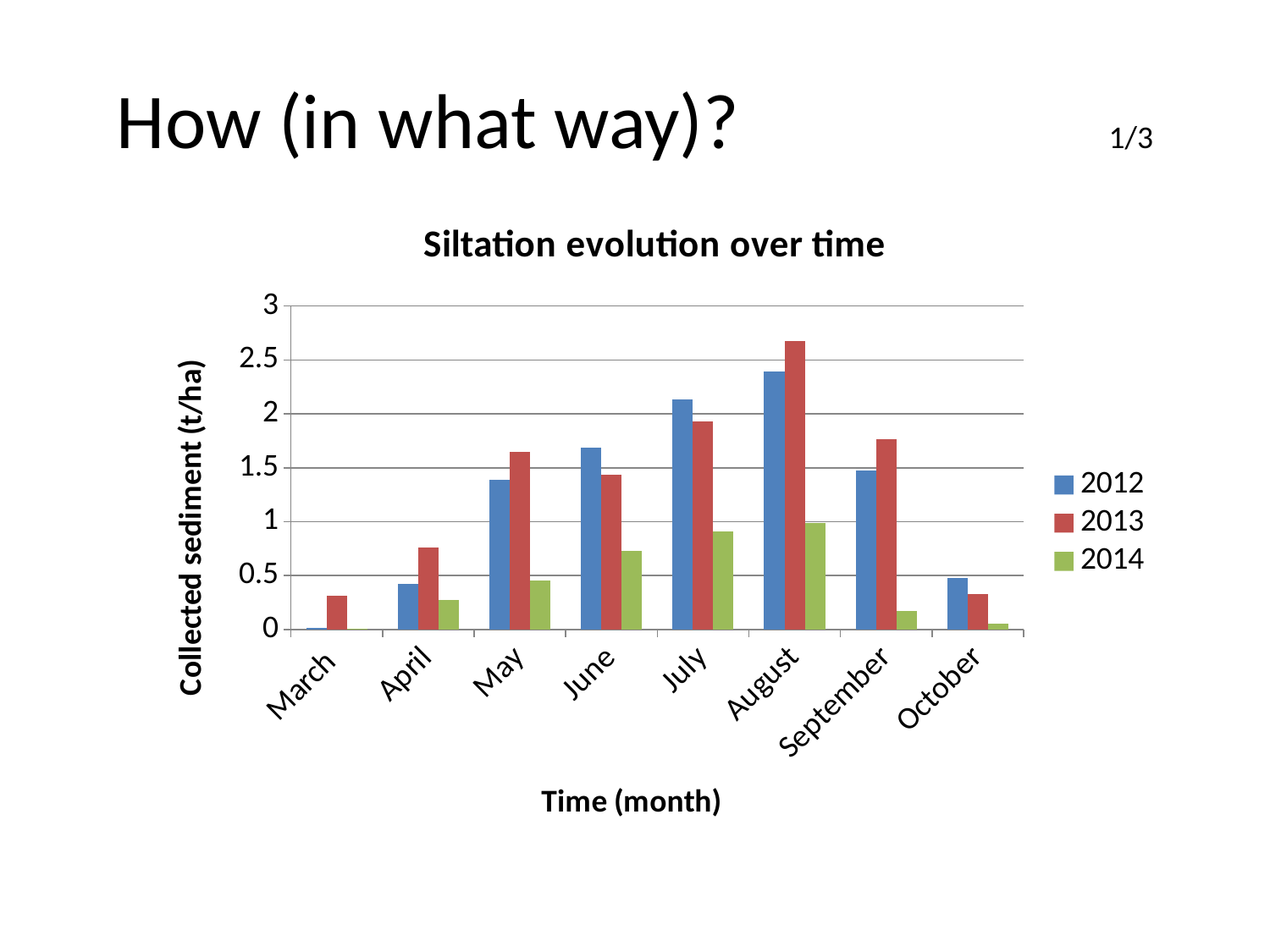
In May, which series has the larger value, 2012 or 2013? 2013 In which month is the 2013 value highest? August Is the 2014 value for July greater or less than 1? less What is the title of the y axis? Collected sediment (t/ha) In June, which series has the larger value, 2012 or 2013? 2012 In which month is the 2012 value highest? August Is the 2012 value for July greater or less than 2? greater How many series does the legend list? 3 What kind of chart is shown on the slide? bar chart In which month is the 2012 value lowest? March Is the 2013 value for August greater or less than 2.5? greater How many months are shown on the x axis? 8